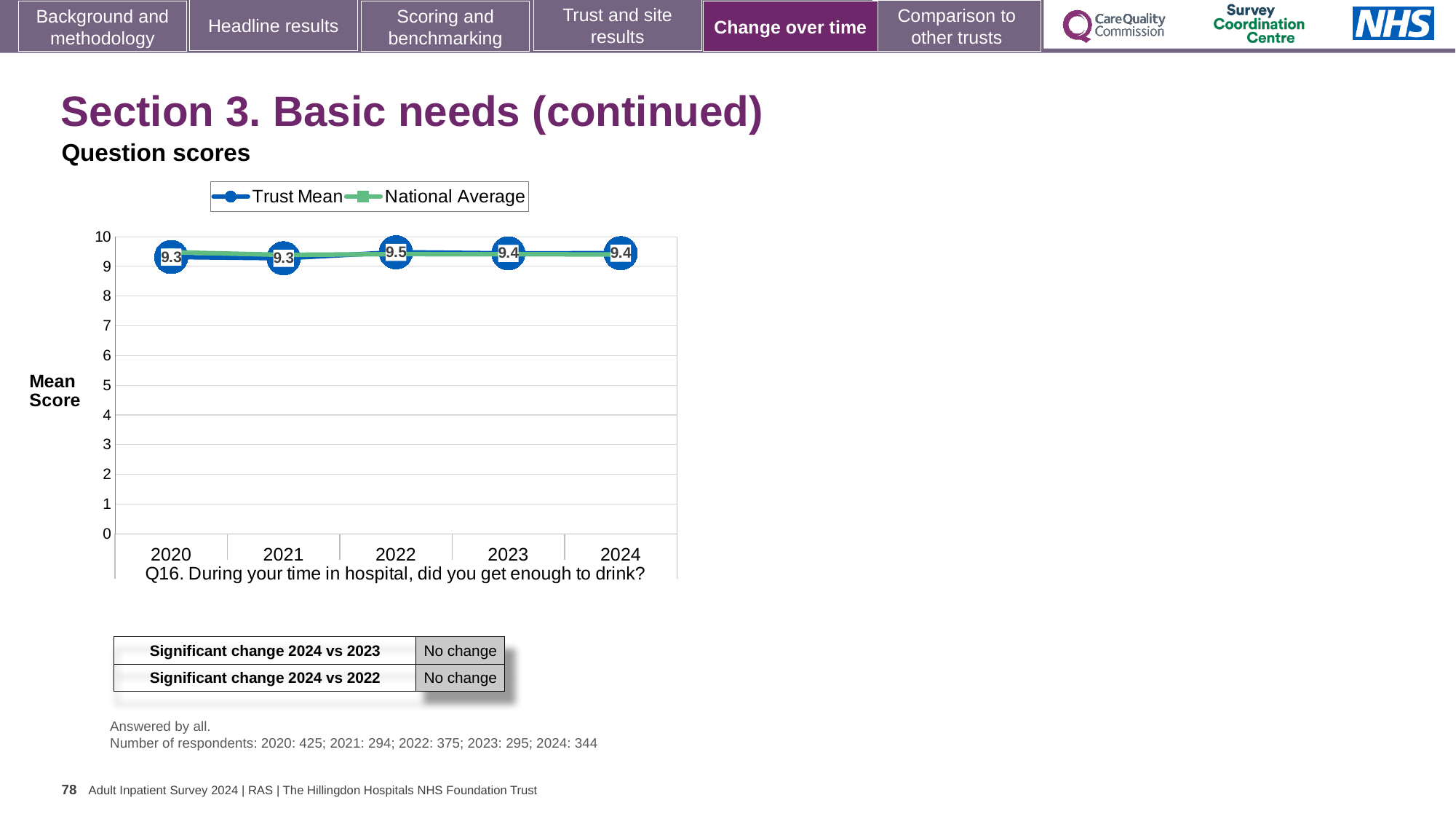
How many series does the legend list? 2 What kind of chart is shown on the slide? line chart What is the difference between the Trust Mean scores for 2022 and 2020? 0.2 What is the Trust Mean score for 2020? 9.3 What is the Trust Mean score for 2024? 9.4 What is the Trust Mean score for 2022? 9.5 Does the Trust Mean score rise or fall from 2021 to 2022? rise Which year has the larger Trust Mean score, 2021 or 2022? 2022 What are the two series named in the legend? Trust Mean and National Average How many years are plotted on the x axis? 5 In which year is the Trust Mean score highest? 2022 Is the National Average value for 2020 greater or less than 9? greater